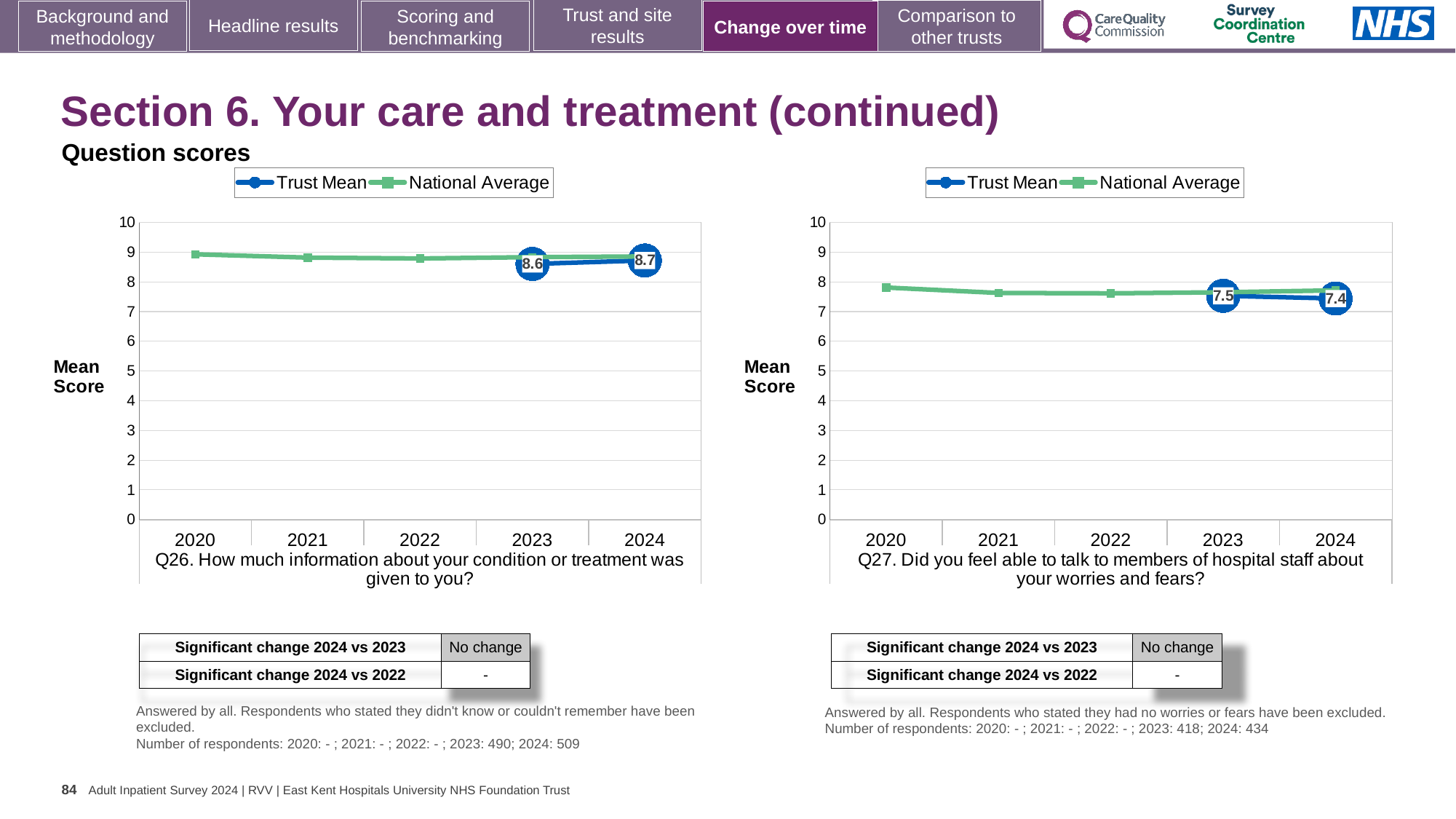
In the Q26 chart, what is the Trust Mean score for 2023? 8.6 In the Q26 chart, by how much did the Trust Mean change from 2023 to 2024? 0.1 What type of chart is used for Q27? line chart In the Q26 chart, what is the Trust Mean score for 2024? 8.7 In the Q26 chart, does the Trust Mean rise or fall from 2023 to 2024? rise How many years are shown on the x axis of the Q27 chart? 5 In the Q27 chart, what is the Trust Mean score for 2024? 7.4 In the Q27 chart, which year has the higher Trust Mean, 2023 or 2024? 2023 How many series does the legend of the Q26 chart list? 2 In the Q26 chart, is the National Average for 2020 greater or less than 8? greater In the Q27 chart, what is the Trust Mean score for 2023? 7.5 In the Q27 chart, does the Trust Mean rise or fall from 2023 to 2024? fall